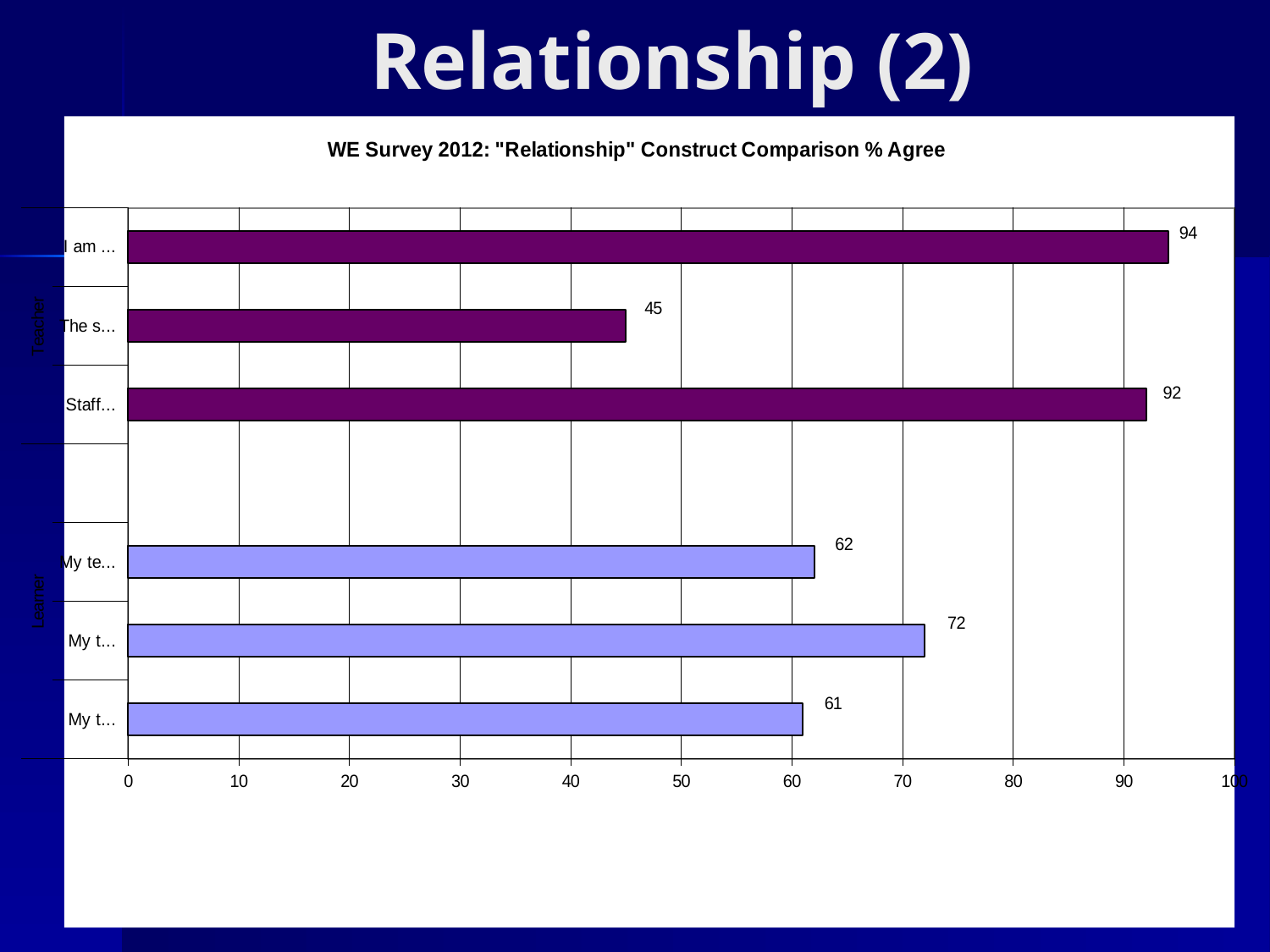
What is the value of the bar labelled "The s..."? 45 What is the title of the chart? WE Survey 2012: "Relationship" Construct Comparison % Agree How many bars are plotted in the chart? 6 Which bar is larger, "Staff..." or "The s..."? Staff... What are the two group labels shown along the vertical axis of the chart? Teacher and Learner What kind of chart is shown on the slide? Bar chart What is the value of the bar labelled "Staff..."? 92 What is the value of the top bar (labelled "I am ...")? 94 What is the highest value shown in the chart? 94 What is the value of the bottom bar in the chart? 61 What is the difference between the highest value (94) and the lowest value (45)? 49 What is the lowest value shown in the chart? 45